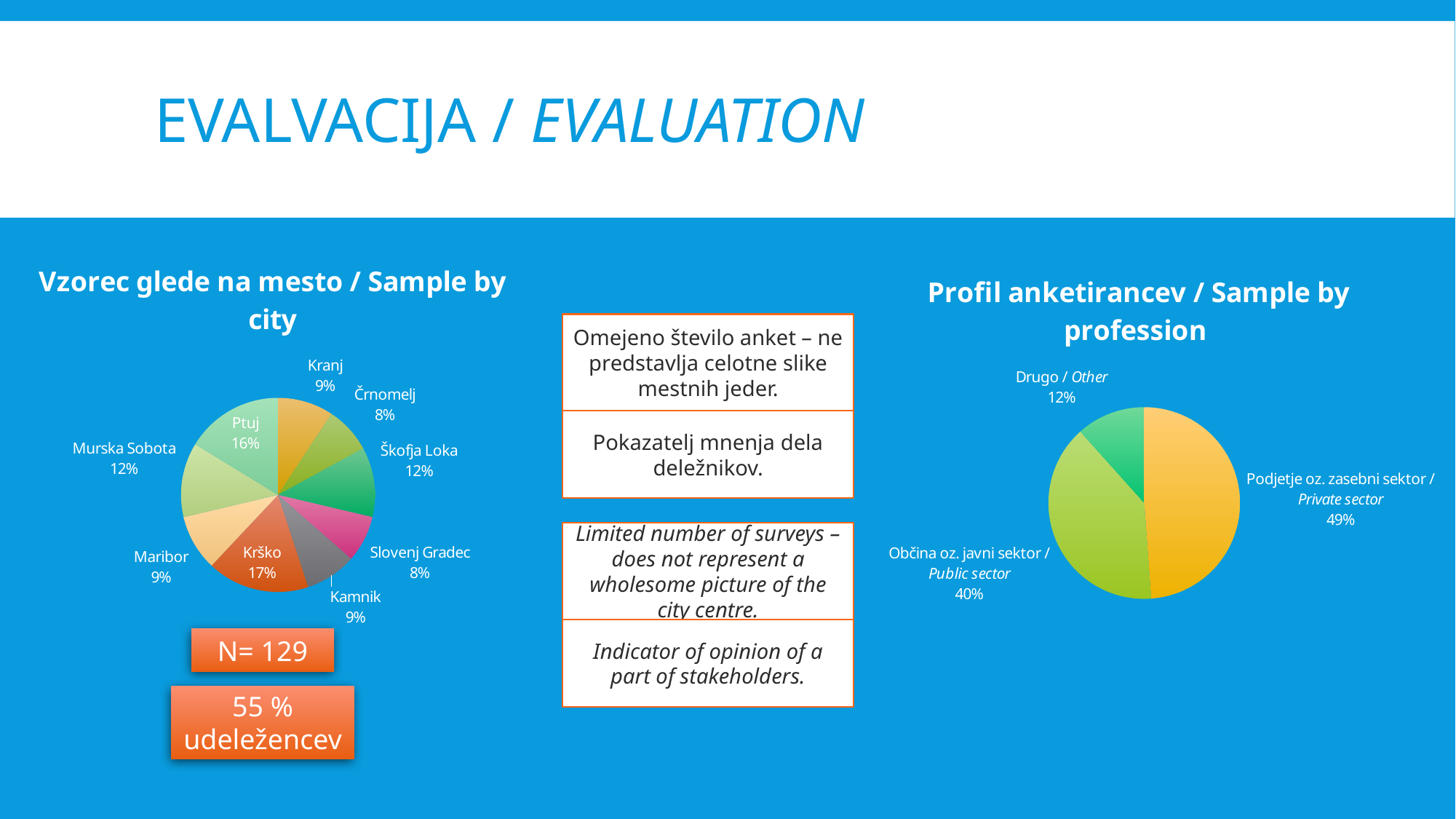
In the 'Sample by city' chart, which has a larger share, Škofja Loka or Maribor? Škofja Loka In the 'Sample by profession' chart, what is the difference between the Private sector and Public sector shares? 9% In the 'Sample by profession' chart, what share does the Private sector have? 49% In the 'Sample by city' chart, what share does Krško have? 17% In the 'Sample by city' chart, how many cities are shown? 9 In the 'Sample by profession' chart, how many categories are shown? 3 In the 'Sample by city' chart, what share does Ptuj have? 16% What type of chart is the 'Sample by profession' chart? Pie chart In the 'Sample by city' chart, what share does Murska Sobota have? 12% In the 'Sample by city' chart, what is the difference between the shares of Krško and Kamnik? 8% In the 'Sample by profession' chart, which category has the smallest share? Drugo / Other In the 'Sample by city' chart, which city has the largest share? Krško